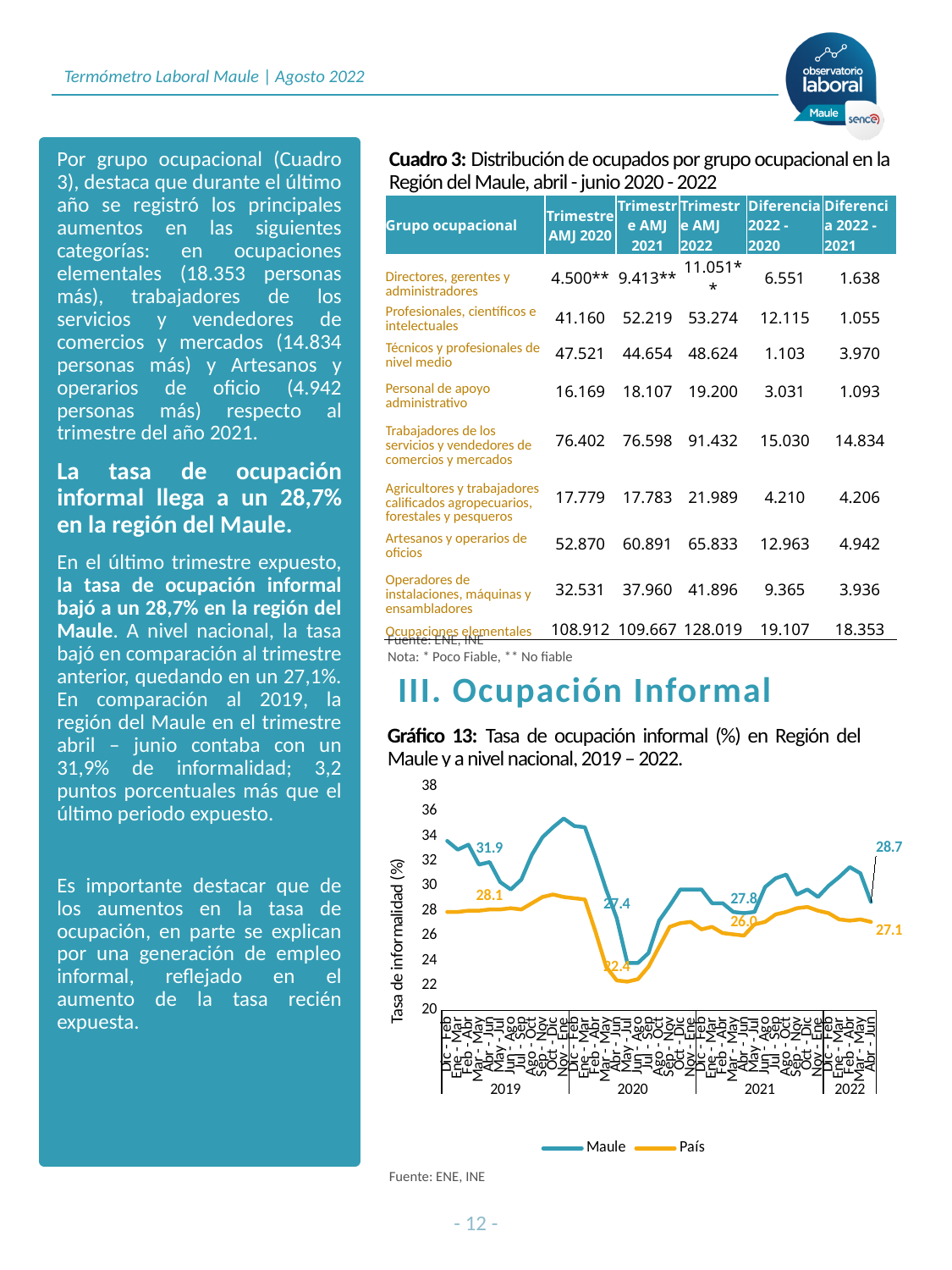
How many series does the legend of Gráfico 13 list? 2 In Gráfico 13, is the peak of the Maule line in late 2019 greater or less than 34? greater In Gráfico 13, what is the difference between the labelled Maule value (28.7) and the labelled País value (27.1) for Abr-Jun 2022? 1.6 What are the two series named in the legend of Gráfico 13? Maule and País In Gráfico 13, what is the labelled informality rate for País in the Abr-Jun 2022 quarter? 27.1 In Gráfico 13, which is the lowest of the labelled values shown on the chart? 22.4 In Gráfico 13, what is the labelled value for País in the Abr-Jun 2020 quarter? 22.4 In Gráfico 13, by how much did the labelled Maule value fall from Abr-Jun 2019 (31.9) to Abr-Jun 2022 (28.7)? 3.2 In Gráfico 13, which series has the higher labelled value in Abr-Jun 2022, Maule or País? Maule What kind of chart is Gráfico 13? line chart In Gráfico 13, what is the labelled value for Maule in the Abr-Jun 2019 quarter? 31.9 In Gráfico 13, what is the labelled informality rate for Maule in the Abr-Jun 2022 quarter? 28.7